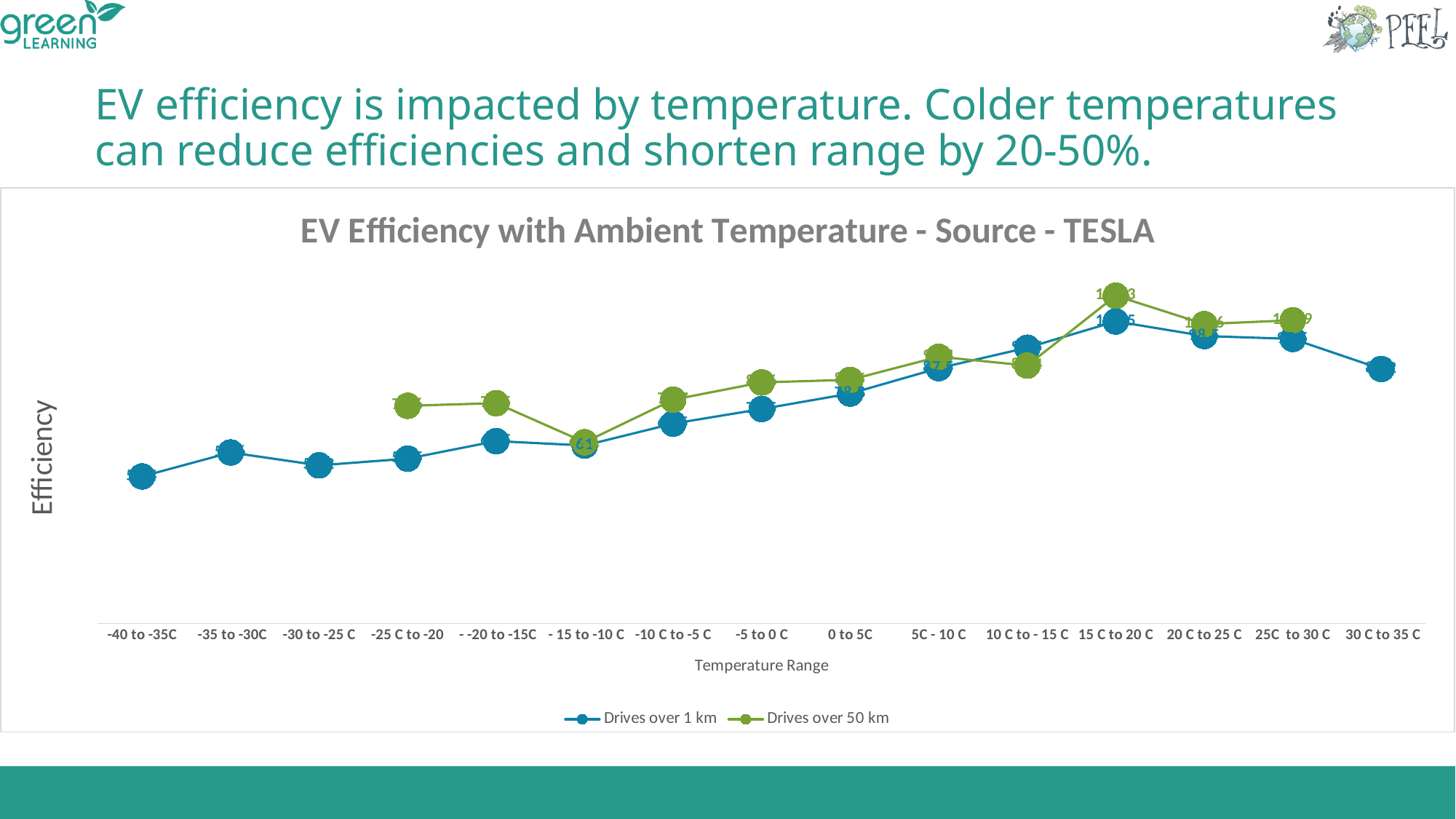
What kind of chart is shown on the slide? Line chart How many temperature range categories are shown on the x axis? 15 At 10 C to -15 C, which series has the higher value, Drives over 1 km or Drives over 50 km? Drives over 1 km What is the title of the chart? EV Efficiency with Ambient Temperature - Source - TESLA Which temperature range has the lowest value for Drives over 1 km? -40 to -35C Which temperature range has the lowest value for Drives over 50 km? - 15 to -10 C Do the efficiency values generally rise or fall as the temperature range moves from coldest to warmest along the x axis? Rise At -25 C to -20, which series has the higher value, Drives over 1 km or Drives over 50 km? Drives over 50 km How many data points does the Drives over 50 km series have? 11 Which temperature range has the highest value for Drives over 50 km? 15 C to 20 C Which temperature range has the highest value for Drives over 1 km? 15 C to 20 C How many series does the legend list? 2